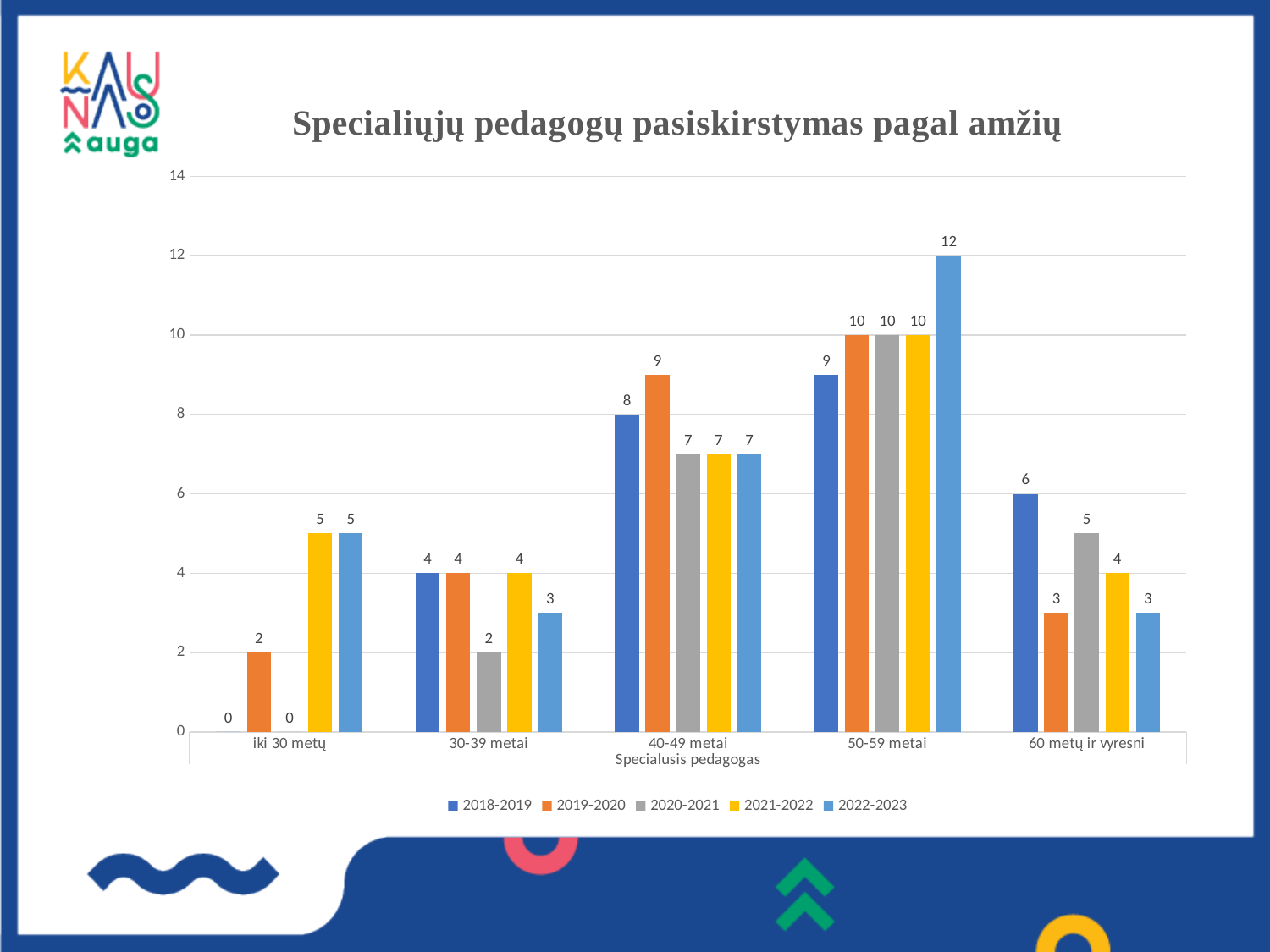
What is the title of the chart? Specialiųjų pedagogų pasiskirstymas pagal amžių How many series does the legend list? 5 How many age categories are shown on the x axis? 5 What kind of chart is shown on the slide? bar chart What is the value for 2022-2023 in the 50-59 metai category? 12 Which age category has the highest value for the 2022-2023 series? 50-59 metai Which is larger in the 40-49 metai category: the 2018-2019 value or the 2019-2020 value? 2019-2020 What is the value for 2018-2019 in the 60 metų ir vyresni category? 6 What is the value for 2020-2021 in the 30-39 metai category? 2 What is the difference between the 2022-2023 and 2018-2019 values in the 50-59 metai category? 3 Which age category has the lowest value for the 2018-2019 series? iki 30 metų What is the value for 2019-2020 in the iki 30 metų category? 2